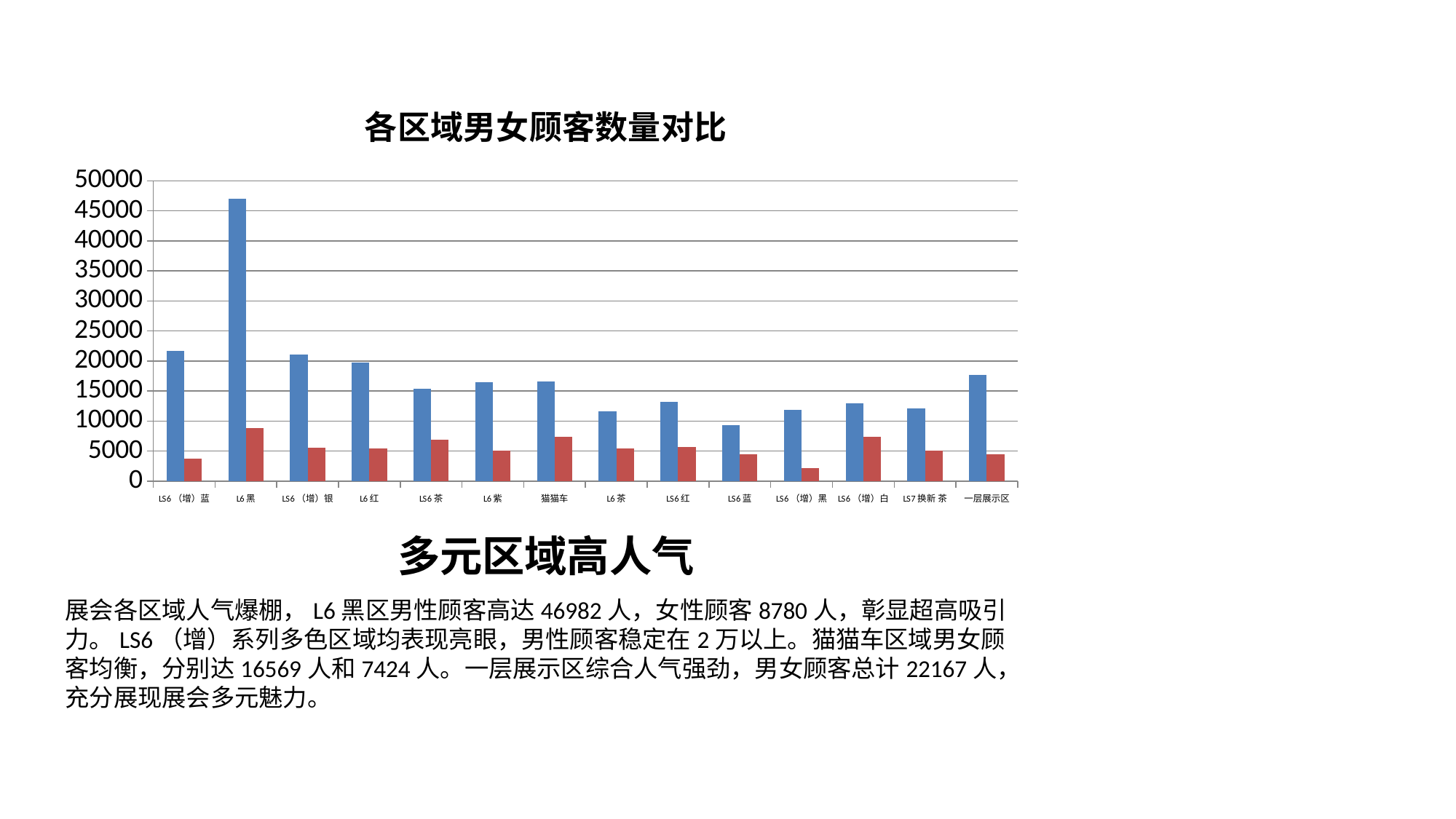
What is the title of the chart? 各区域男女顾客数量对比 Which has the taller red bar, 猫猫车 or LS6蓝? 猫猫车 Which category has the shortest red bar? LS6（增）黑 Which category has the shortest blue bar? LS6蓝 Is the blue bar for LS6蓝 greater or less than 10000? less Which has the taller blue bar, L6红 or LS6茶? L6红 Is the blue bar for L6黑 greater or less than 45000? greater Which category has the tallest red bar? L6黑 Is the red bar for 猫猫车 greater or less than 5000? greater How many categories are shown on the x axis of the chart? 14 What type of chart is shown on the slide? bar chart Which category has the tallest blue bar? L6黑